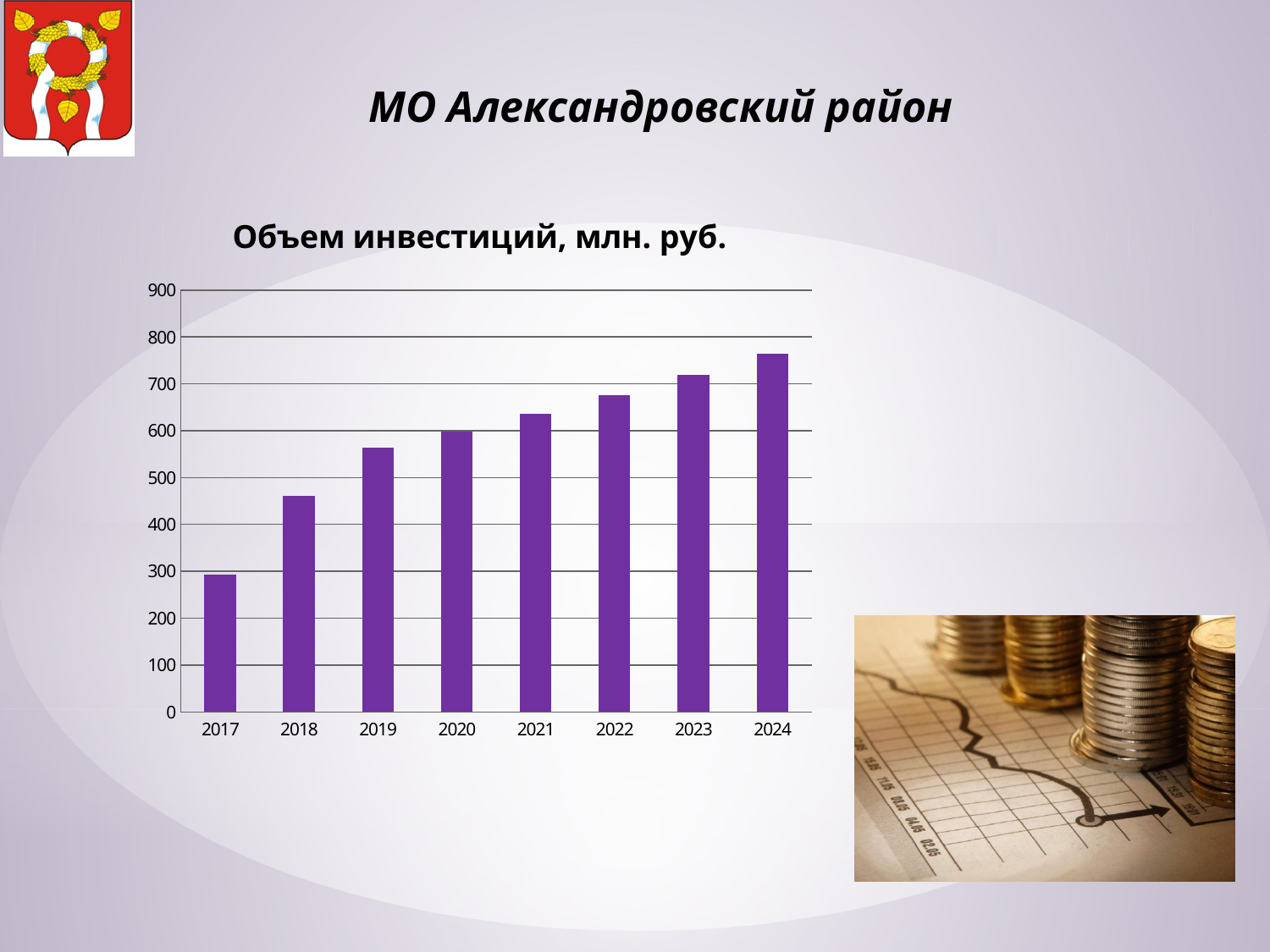
How many years are shown on the x axis of the chart? 8 What colour are the bars in the chart? purple Is the value for 2023 greater or less than 700? greater Which year has the lowest investment volume? 2017 Which year has the highest investment volume? 2024 Do the values rise or fall from 2017 to 2024? rise What is the title of the chart? Объем инвестиций, млн. руб. Which is larger, the value for 2019 or the value for 2022? 2022 What type of chart is shown on the slide? bar chart Is the value for 2018 greater or less than 400? greater Is the value for 2024 greater or less than 800? less